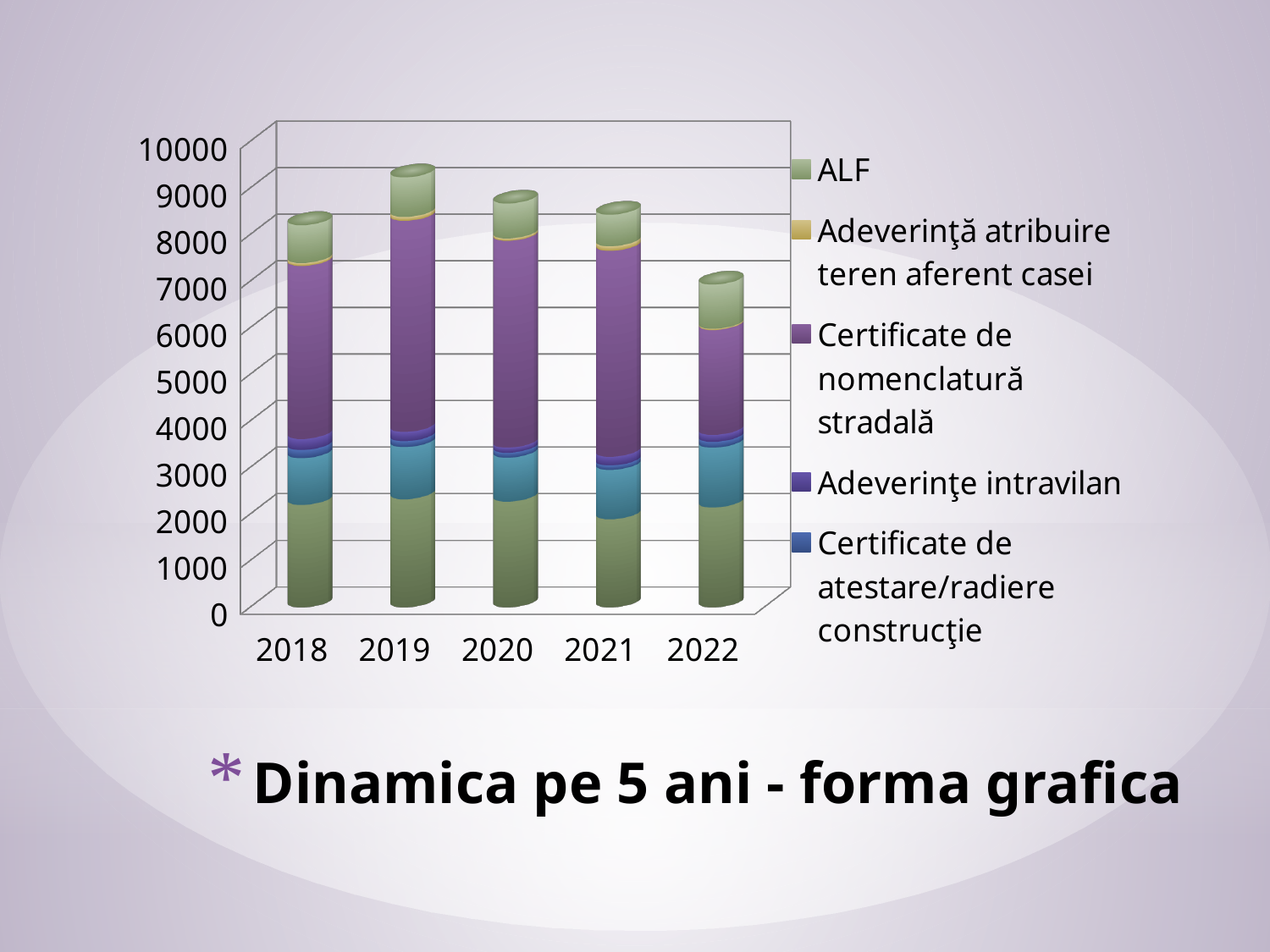
How many series does the chart legend list? 5 Which year has a larger total, 2019 or 2022? 2019 Which year has the shortest stacked bar? 2022 Is the total for 2018 greater or less than 7000? greater Which year has the tallest stacked bar? 2019 Is the total for 2022 greater or less than 8000? less Is the total for 2019 greater or less than 9000? greater Which series takes up the largest portion of each stacked bar? Certificate de nomenclatură stradală How many years are shown on the x axis of the chart? 5 What is the text of the slide title below the chart? Dinamica pe 5 ani - forma grafica Do the stacked bar totals rise or fall from 2019 to 2022? fall What kind of chart is shown on the slide? Stacked bar chart